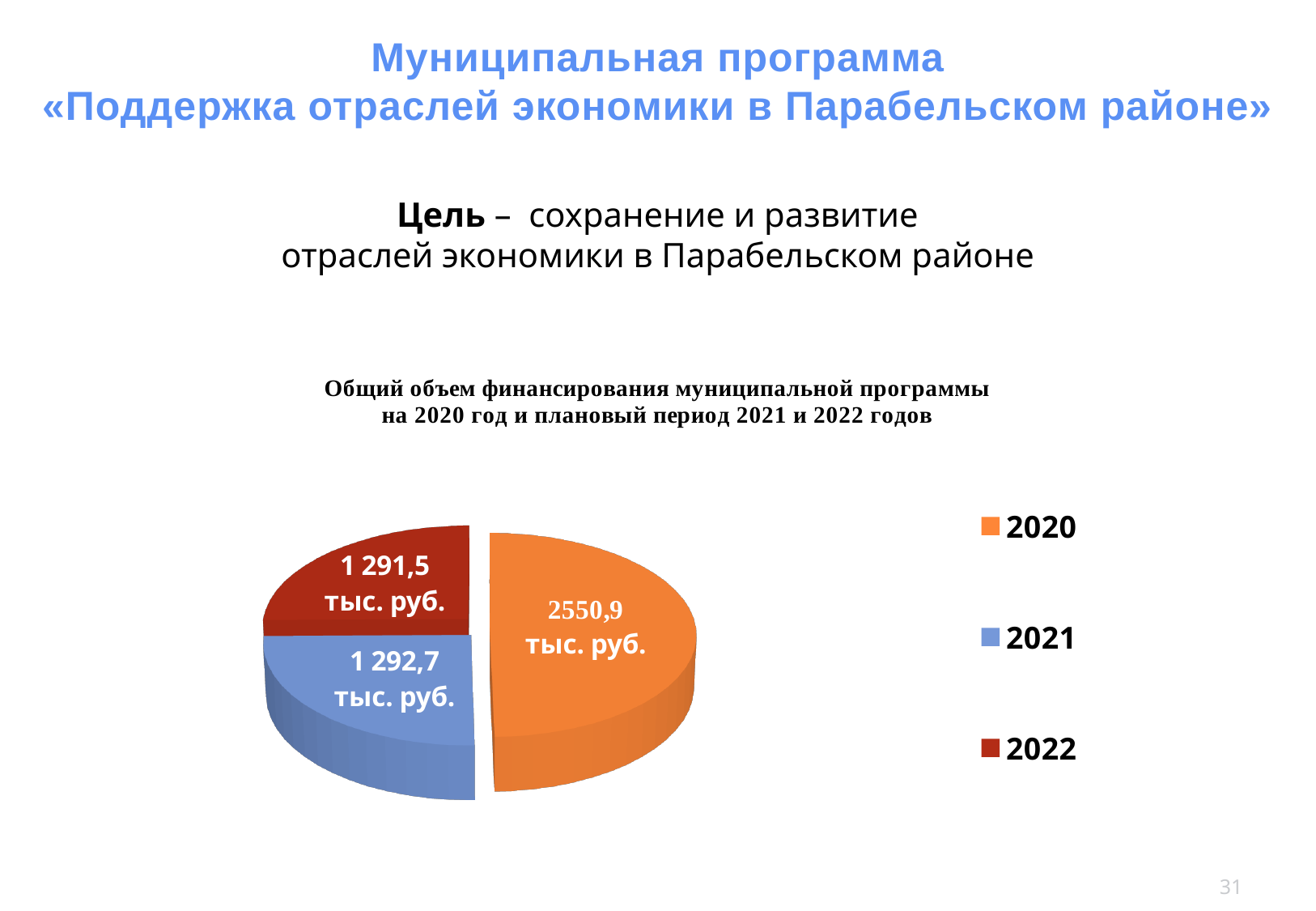
What is the difference between the values for 2020 and 2021? 1 258,2 тыс. руб. What is the value shown for 2020 on the pie chart? 2550,9 тыс. руб. Which year has the largest slice of the pie chart? 2020 What colour is the slice for 2020? Orange What kind of chart is shown on the slide? Pie chart What is the value shown for 2022 on the pie chart? 1 291,5 тыс. руб. What is the total of all three slices of the pie chart? 5 135,1 тыс. руб. Which is larger, the value for 2020 or the value for 2021? 2020 Which year has the smallest value on the pie chart? 2022 How many slices does the pie chart have? 3 What is the value shown for 2021 on the pie chart? 1 292,7 тыс. руб. What is the difference between the values for 2021 and 2022? 1,2 тыс. руб.